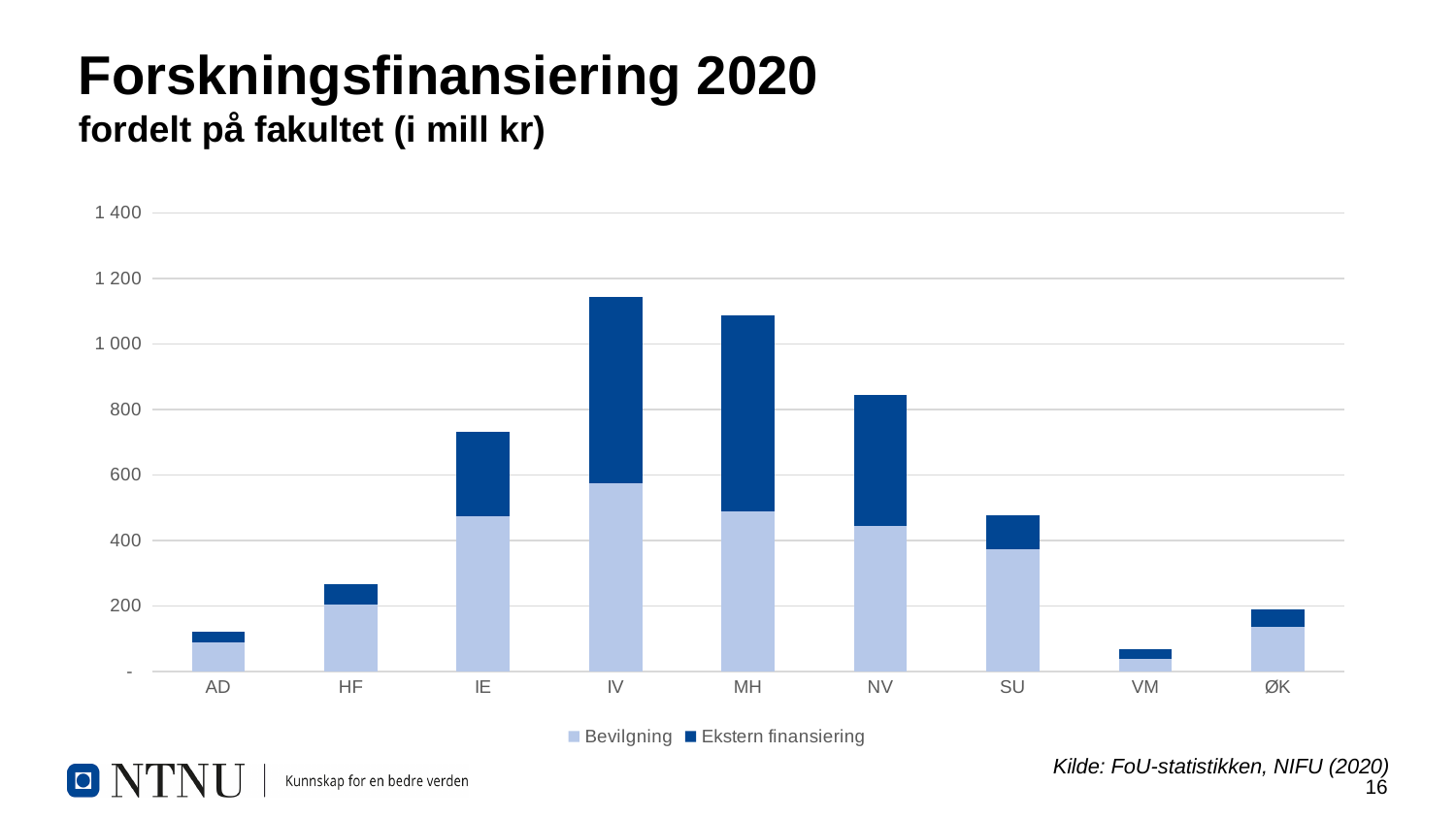
Is the total value for IV greater or less than 1 000? greater Is the total value for AD greater or less than 200? less Which has a larger Bevilgning value, IV or MH? IV What kind of chart is shown on the slide? Stacked bar chart Is the total value for SU greater or less than 600? less How many faculties (categories) are shown on the x axis? 9 Which faculty has the lowest total research funding? VM What are the two series named in the legend? Bevilgning and Ekstern finansiering Which has a larger total, IE or SU? IE Which faculty has the highest total research funding? IV How many series does the legend list? 2